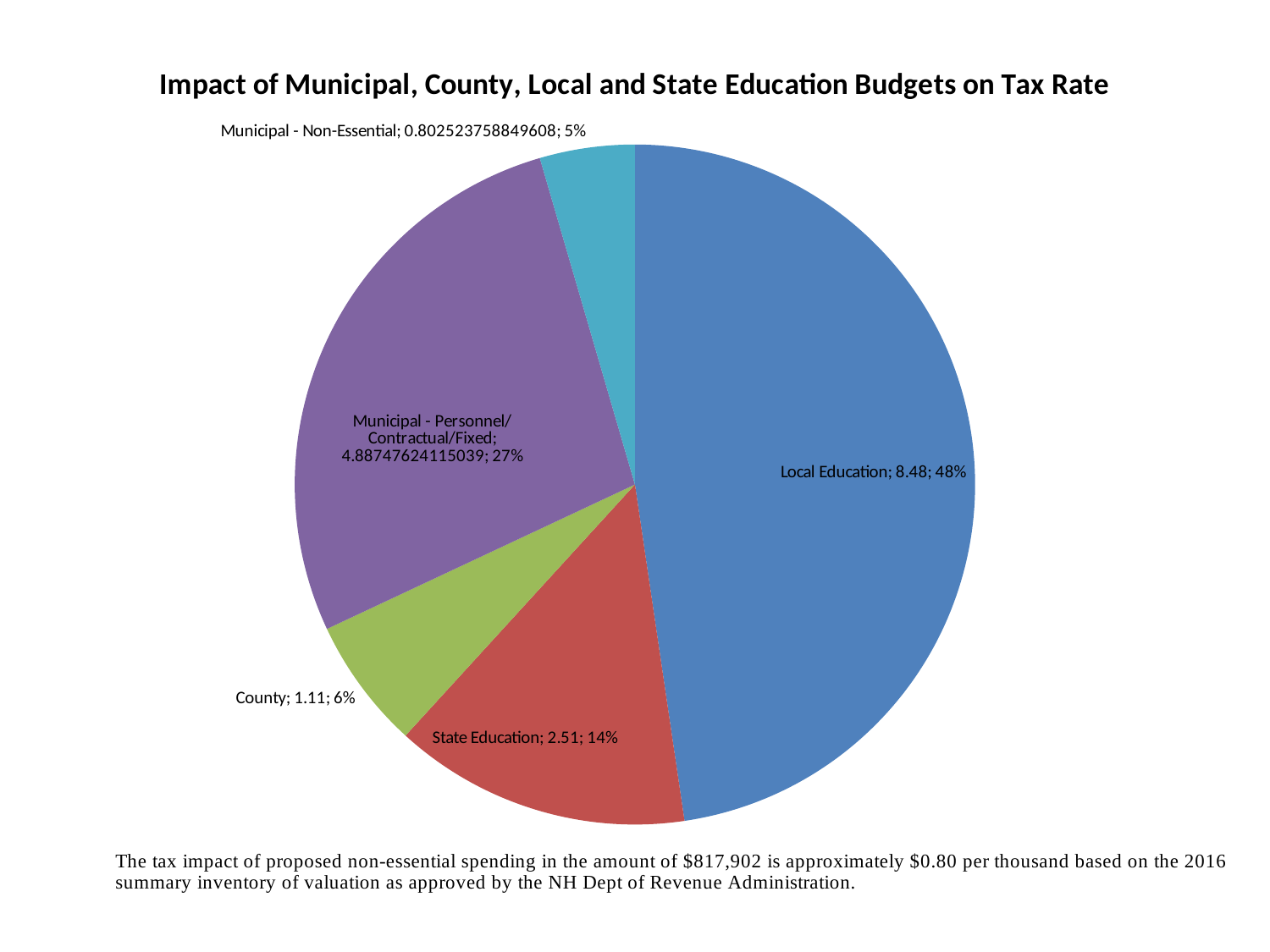
What percentage share of the pie does Local Education represent? 48% What percentage share of the pie does Municipal - Personnel/Contractual/Fixed represent? 27% Which category has the largest slice of the pie? Local Education What is the difference between the values for Local Education and State Education? 5.97 What is the value shown for Local Education? 8.48 Which category has the smallest slice of the pie? Municipal - Non-Essential What kind of chart is shown on the slide? Pie chart What is the value shown for County? 1.11 What is the value shown for State Education? 2.51 How many slices does the pie chart have? 5 What percentage share of the pie does Municipal - Non-Essential represent? 5% What is the title of the chart? Impact of Municipal, County, Local and State Education Budgets on Tax Rate